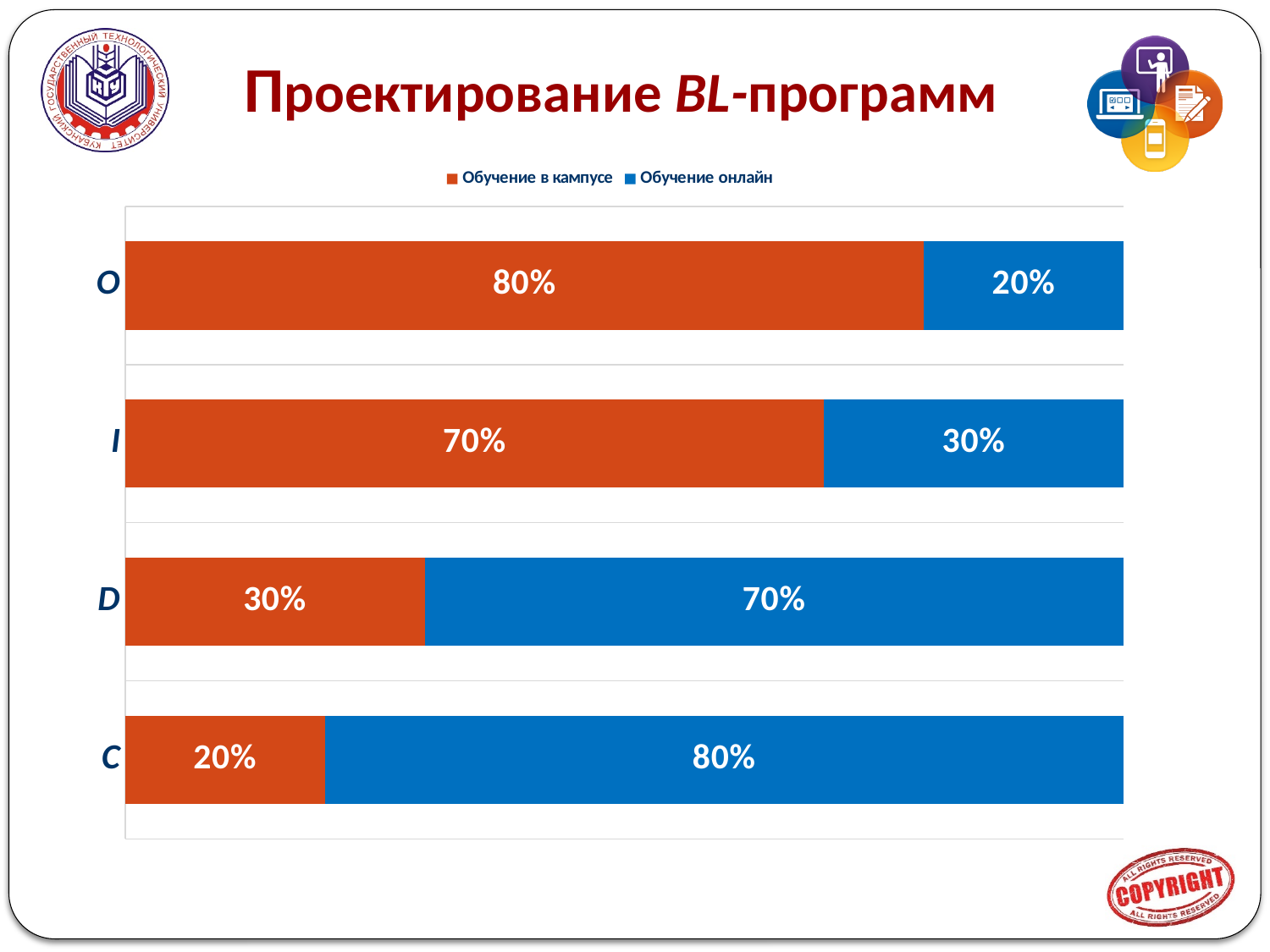
How many series does the legend list? 2 What is the value of "Обучение онлайн" for category D? 70% Which category has the highest value for "Обучение в кампусе"? O What is the value of "Обучение в кампусе" for category O? 80% What is the value of "Обучение онлайн" for category I? 30% What kind of chart is shown on the slide? Stacked bar chart Which category has the lowest value for "Обучение онлайн"? O What is the difference between the "Обучение в кампусе" values for O and I? 10% What is the total of the stacked bar for category I? 100% How many categories are shown on the chart? 4 Which is larger for category D: "Обучение в кампусе" or "Обучение онлайн"? Обучение онлайн What is the value of "Обучение в кампусе" for category C? 20%